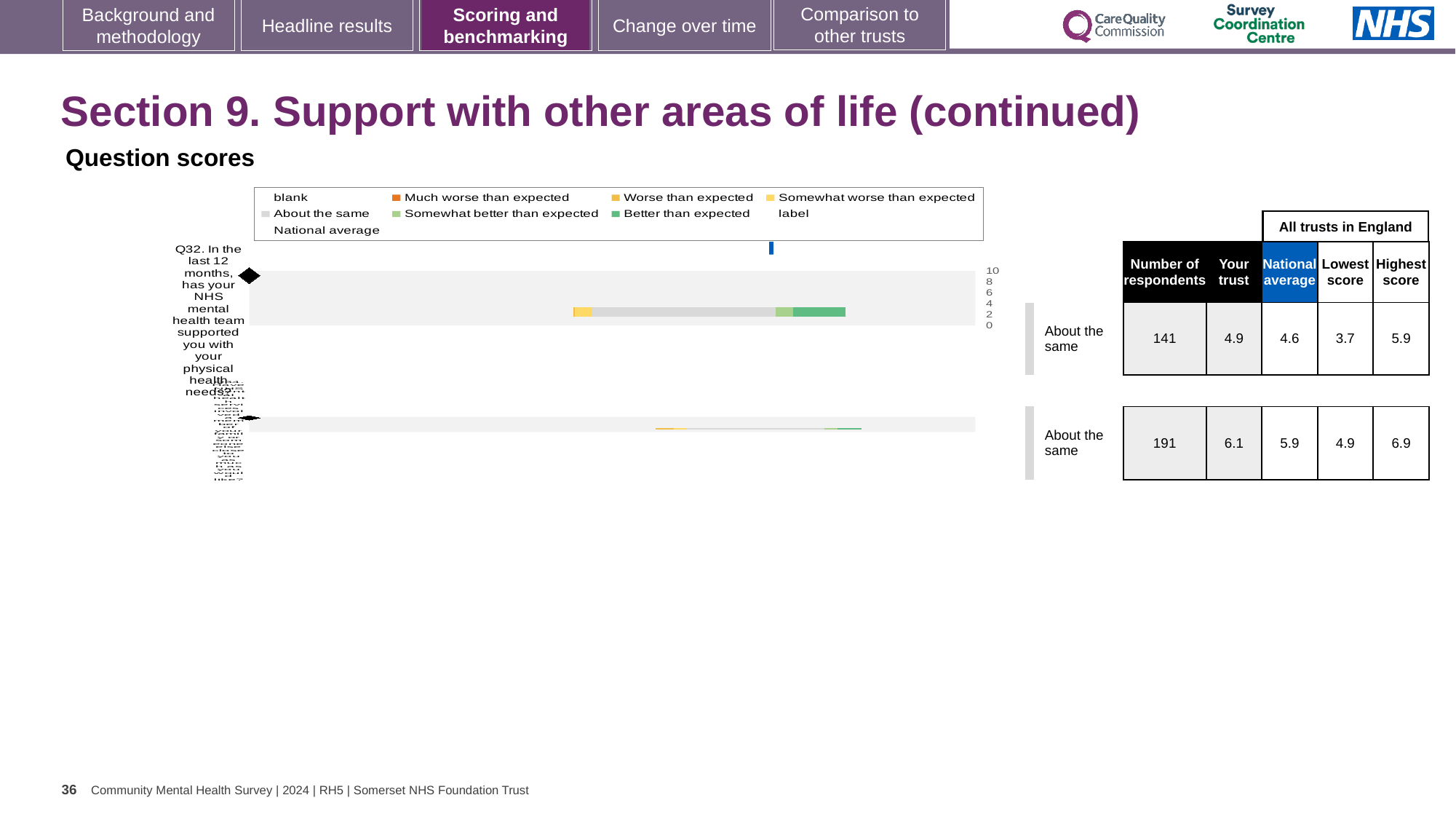
For Q32, how much higher is the 'Your trust' score than the national average? 0.3 How many respondents answered Q32? 141 What is the highest score among all trusts in England for Q32? 5.9 Which colour in the legend represents 'Better than expected'? green What kind of chart is shown under 'Question scores'? bar chart What is the lowest score among all trusts in England for Q32? 3.7 What is the national average score for Q32? 4.6 What is the 'Your trust' score for Q32 (support with physical health needs)? 4.9 Which benchmark category is Q32 placed in? About the same Is the 'Your trust' score for Q32 greater or less than 4? greater For Q32, which is larger: the 'Your trust' score or the national average? Your trust For Q32, what is the difference between the highest and lowest scores among all trusts in England? 2.2